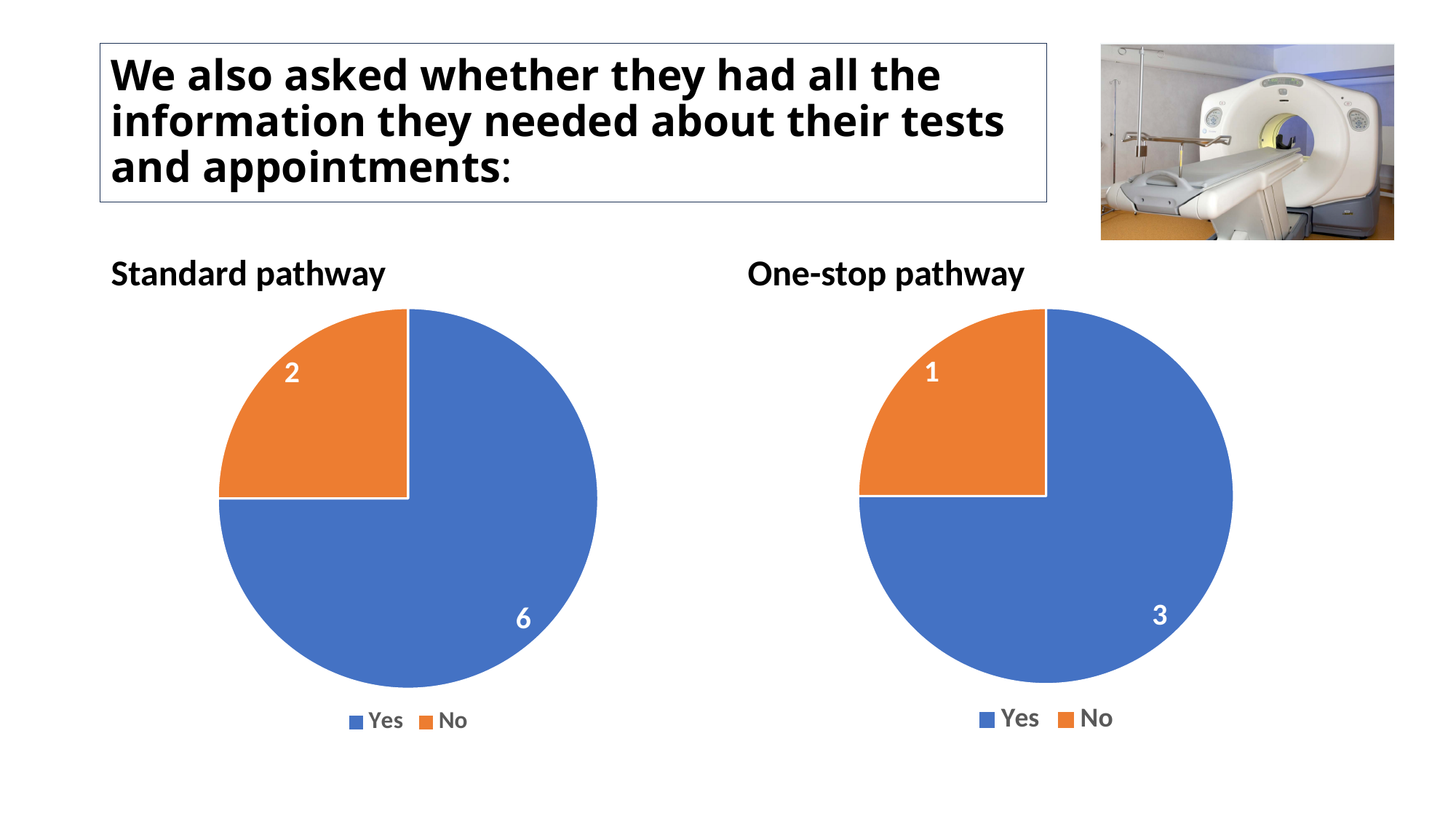
In the One-stop pathway chart, which category is the smallest? No In the One-stop pathway chart, what is the value for Yes? 3 In the One-stop pathway chart, what is the value for No? 1 What kind of chart is the One-stop pathway chart? Pie chart How many slices does the Standard pathway pie chart have? 2 In the Standard pathway chart, which category is the largest? Yes In the Standard pathway chart, what is the value for Yes? 6 In the Standard pathway chart, what share of the pie does No represent? 25% In the One-stop pathway chart, what colour is the No slice? Orange In the One-stop pathway chart, what share of the pie does Yes represent? 75% In the Standard pathway chart, what is the difference between Yes and No? 4 In the Standard pathway chart, what is the value for No? 2